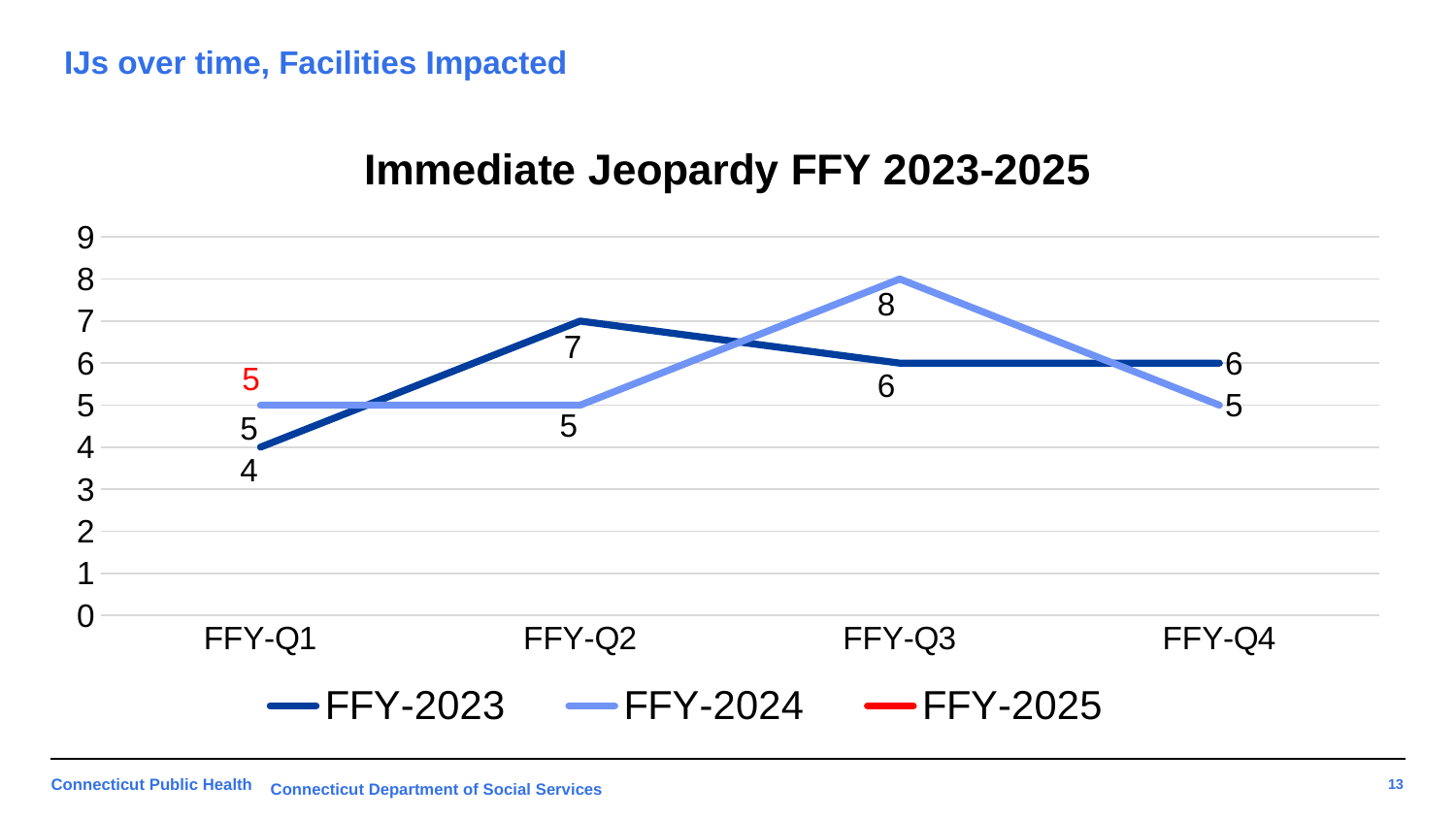
What is the FFY-2023 value for FFY-Q2? 7 What is the FFY-2025 value for FFY-Q1? 5 In which quarter is the FFY-2023 series lowest? FFY-Q1 What is the FFY-2024 value for FFY-Q3? 8 How many quarters are shown on the x axis? 4 What type of chart is shown on the slide? Line chart What is the difference between the FFY-2024 and FFY-2023 values for FFY-Q3? 2 What is the title of the chart? Immediate Jeopardy FFY 2023-2025 How many series does the legend list? 3 Does the FFY-2023 series rise or fall from FFY-Q1 to FFY-Q2? Rise Which series has the larger value for FFY-Q2, FFY-2023 or FFY-2024? FFY-2023 In which quarter is the FFY-2024 series highest? FFY-Q3